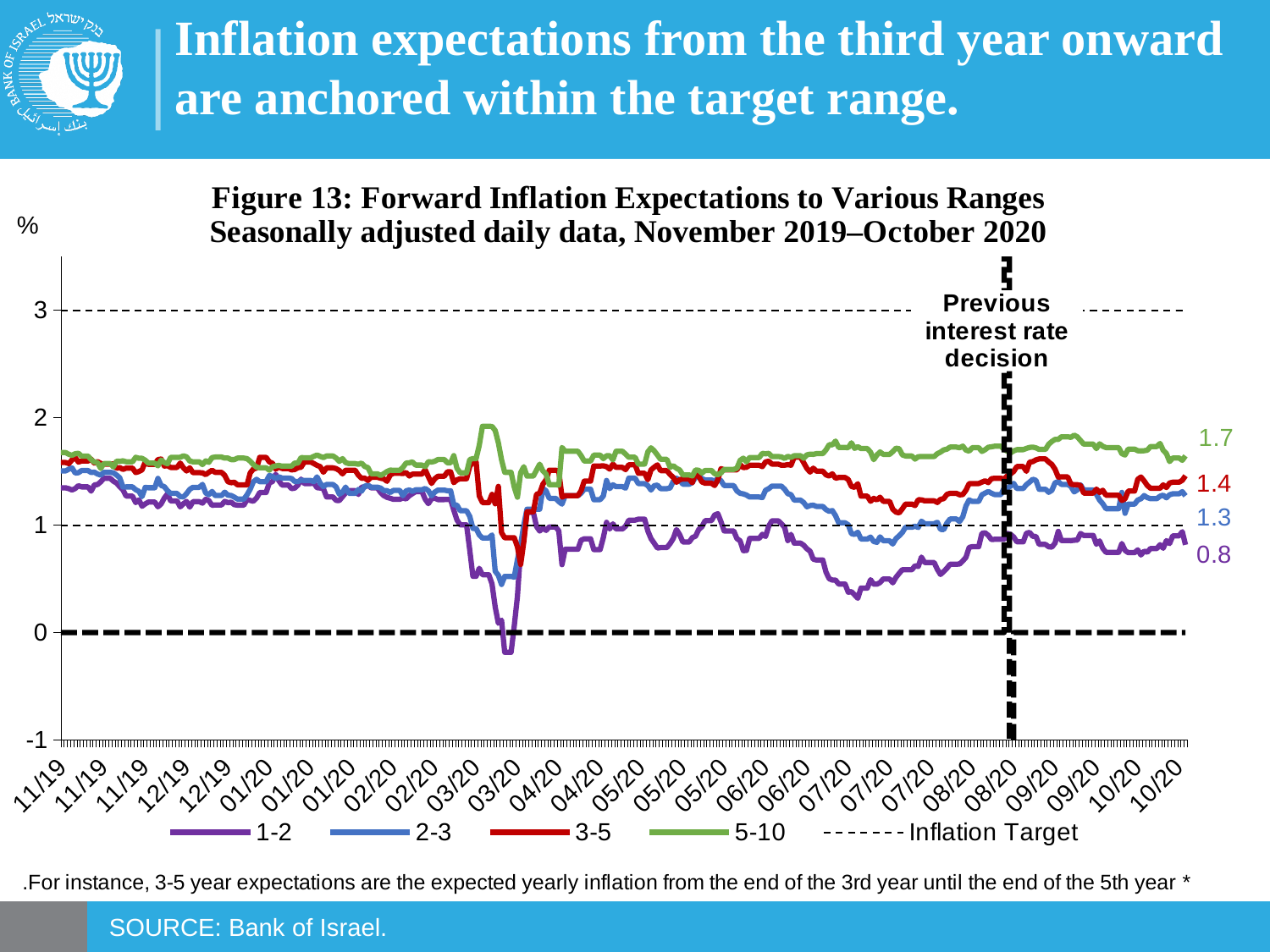
Which series has the highest value at the right end of the chart? 5-10 Which series has the lowest value at the right end of the chart? 1-2 Does the 1-2 series rise or fall between 07/20 and 10/20? rise At the right end of the chart, which is larger: the 3-5 series or the 2-3 series? 3-5 What is the difference between the end-of-period values of the 5-10 series and the 1-2 series? 0.9 How many entries does the legend of Figure 13 list? 5 What kind of chart is Figure 13? line chart Is the lowest point of the 1-2 series in 03/20 greater or less than 0? less What is the latest value labelled for the 1-2 series at the right end of the chart? 0.8 What does the vertical dashed line in the chart mark? Previous interest rate decision What is the latest value labelled for the 2-3 series at the right end of the chart? 1.3 What is the latest value labelled for the 5-10 series at the right end of the chart? 1.7